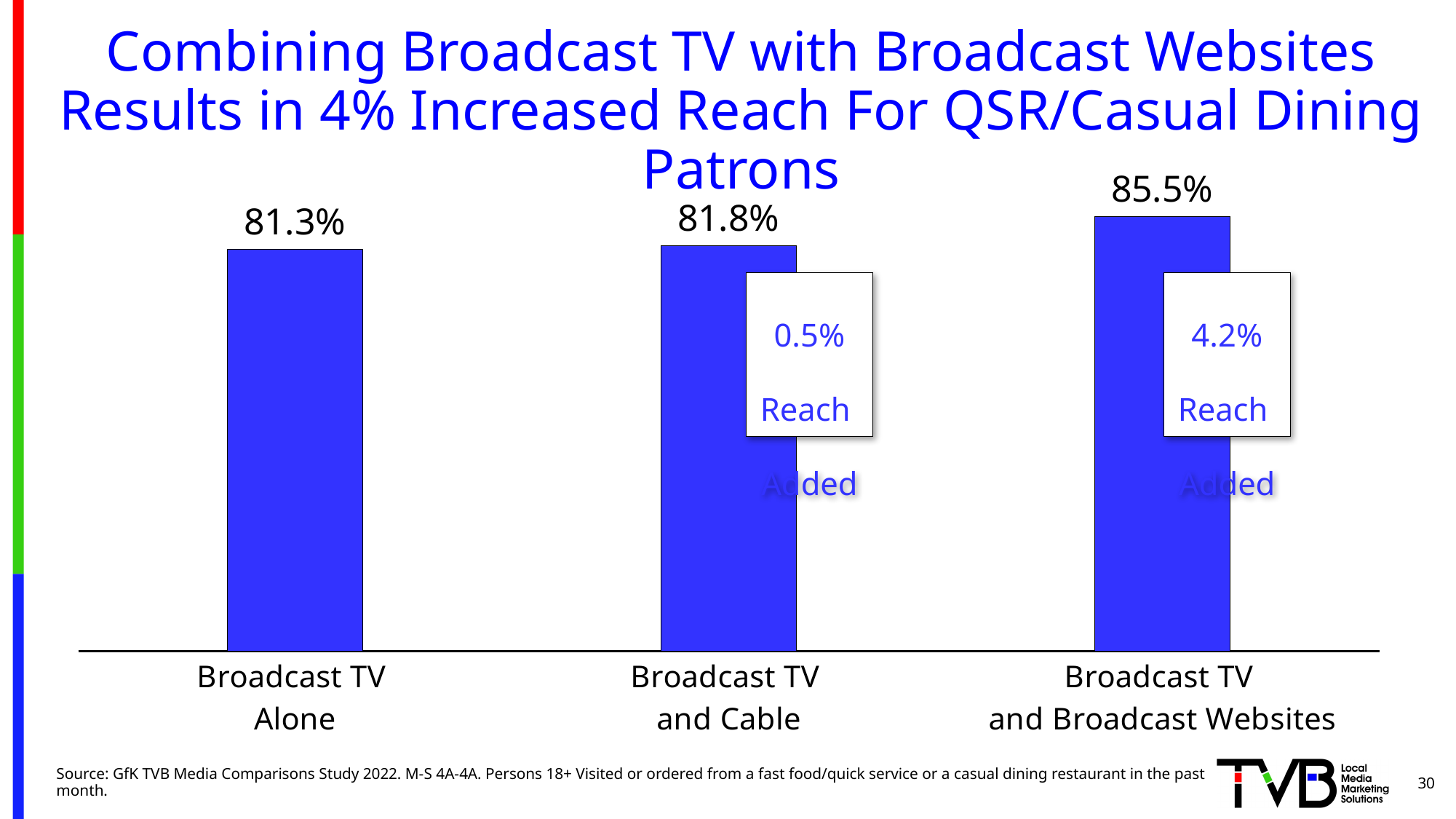
What is the difference between Broadcast TV and Cable and Broadcast TV Alone? 0.5% What reach added is shown in the callout box for Broadcast TV and Broadcast Websites? 4.2% Reach Added How many categories are shown in the chart? 3 What is the value for Broadcast TV and Cable? 81.8% What is the value for Broadcast TV and Broadcast Websites? 85.5% Which category has the lowest value? Broadcast TV Alone Which category has the highest value? Broadcast TV and Broadcast Websites Which is larger: Broadcast TV and Broadcast Websites or Broadcast TV and Cable? Broadcast TV and Broadcast Websites What kind of chart is shown on the slide? Bar chart Do the values rise or fall from left to right across the categories? Rise What is the difference between Broadcast TV and Broadcast Websites and Broadcast TV Alone? 4.2% What is the value for Broadcast TV Alone? 81.3%